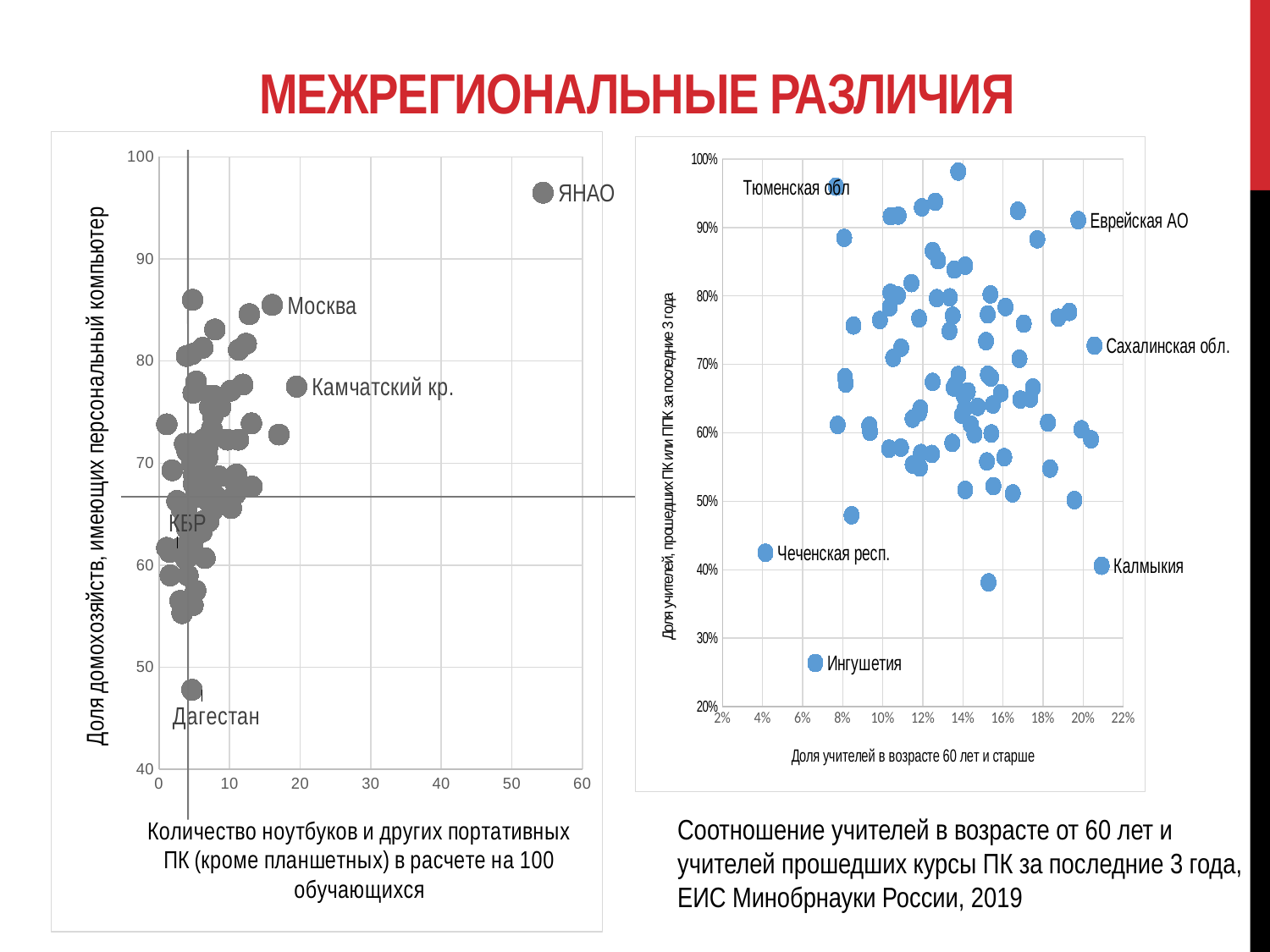
On the right chart, which labeled region is higher on the vertical axis, Еврейская АО or Сахалинская обл.? Еврейская АО On the left chart, which labeled region has the lowest share of households with a personal computer? Дагестан What is the title of the horizontal axis of the right chart? Доля учителей в возрасте 60 лет и старше On the right chart, which labeled region has the lowest share of teachers who completed PC courses in the last 3 years? Ингушетия On the left chart, which labeled region is higher on the vertical axis, Москва or Камчатский кр.? Москва What kind of chart is the right chart on the slide? scatter chart On the right chart, is the value on the vertical axis for Ингушетия greater or less than 30%? less On the left chart, which labeled region has the highest share of households with a personal computer? ЯНАО On the left chart, is the value on the horizontal axis for ЯНАО greater or less than 50? greater What kind of chart is the left chart on the slide? scatter chart On the left chart, is the value on the vertical axis for ЯНАО greater or less than 90? greater